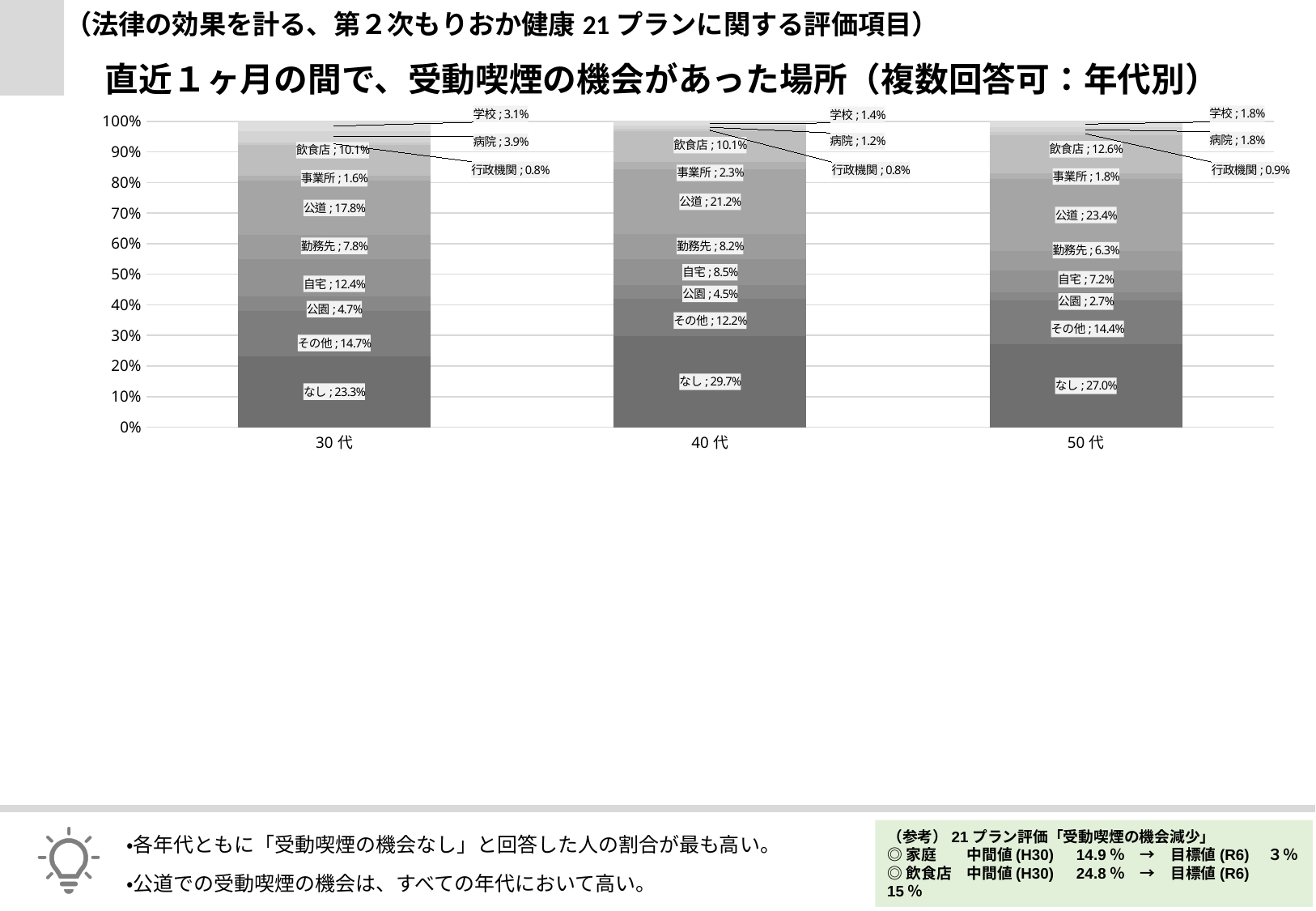
What is the value for 学校 in the 30代 bar? 3.1% What is the title of the chart? 直近１ヶ月の間で、受動喫煙の機会があった場所（複数回答可：年代別） What kind of chart is shown on the slide? Stacked bar chart What is the value for 飲食店 in the 30代 bar? 10.1% What is the value for 公道 in the 50代 bar? 23.4% Which age group has the lowest value for 公道? 30代 What is the value for 自宅 in the 50代 bar? 7.2% Which is larger, the 勤務先 value for 40代 or for 50代? 40代 How many age-group categories are shown on the x axis? 3 Which age group has the highest value for なし? 40代 What is the difference between the 自宅 values for 30代 and 50代? 5.2% What is the value for なし in the 40代 bar? 29.7%